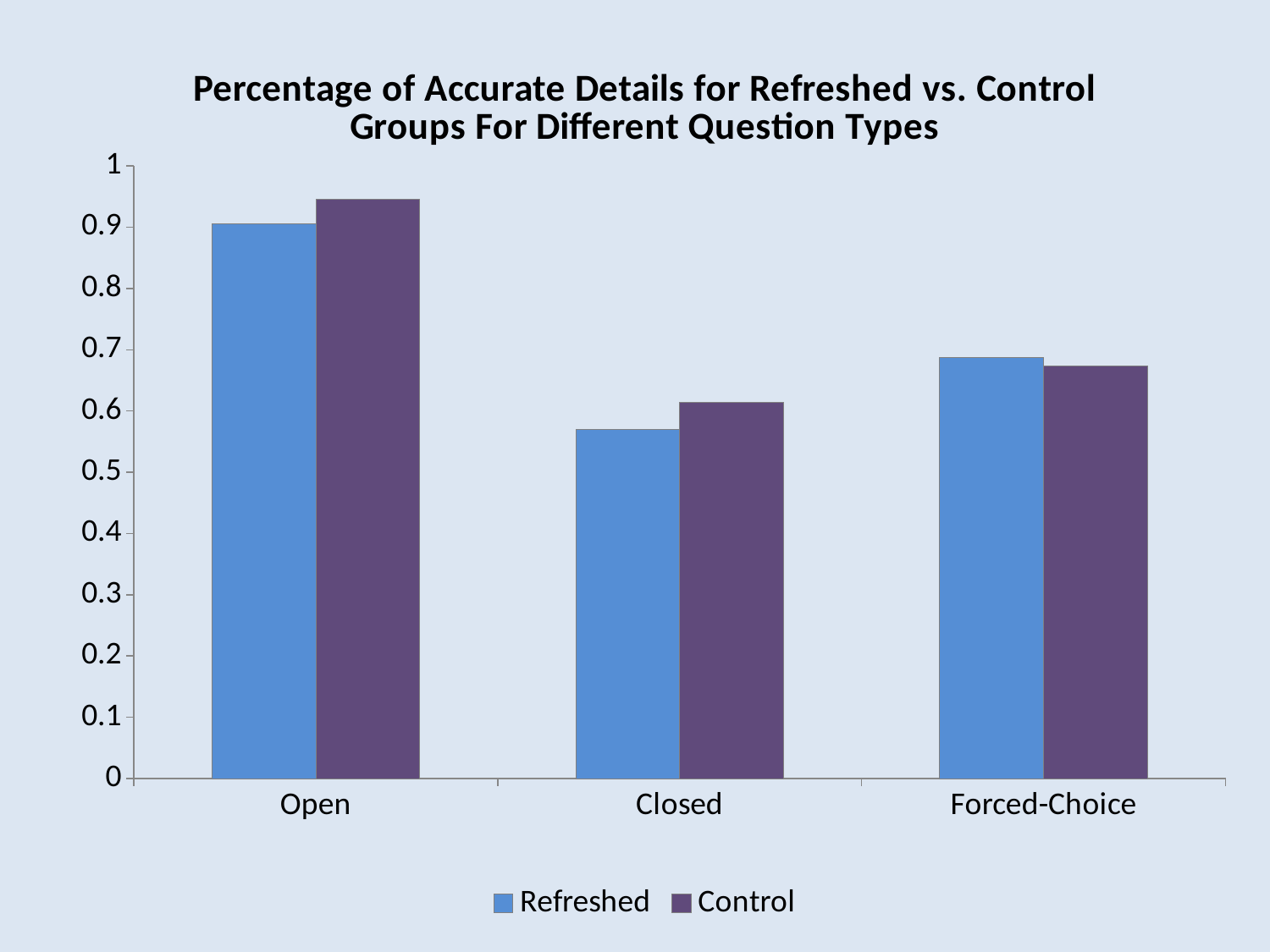
Is the value for the Refreshed group on Closed questions greater or less than 0.6? less How many series does the legend list? 2 What are the two series named in the legend? Refreshed and Control Which question type has the lowest value for the Control group? Closed What kind of chart is shown on the slide? bar chart Which question type has the highest value for the Control group? Open How many question types (categories) are shown on the x axis? 3 Which question type has the lowest value for the Refreshed group? Closed For Closed questions, which group has the larger value, Refreshed or Control? Control Which question type has the highest value for the Refreshed group? Open For Open questions, which group has the larger value, Refreshed or Control? Control Is the value for the Control group on Open questions greater or less than 0.9? greater